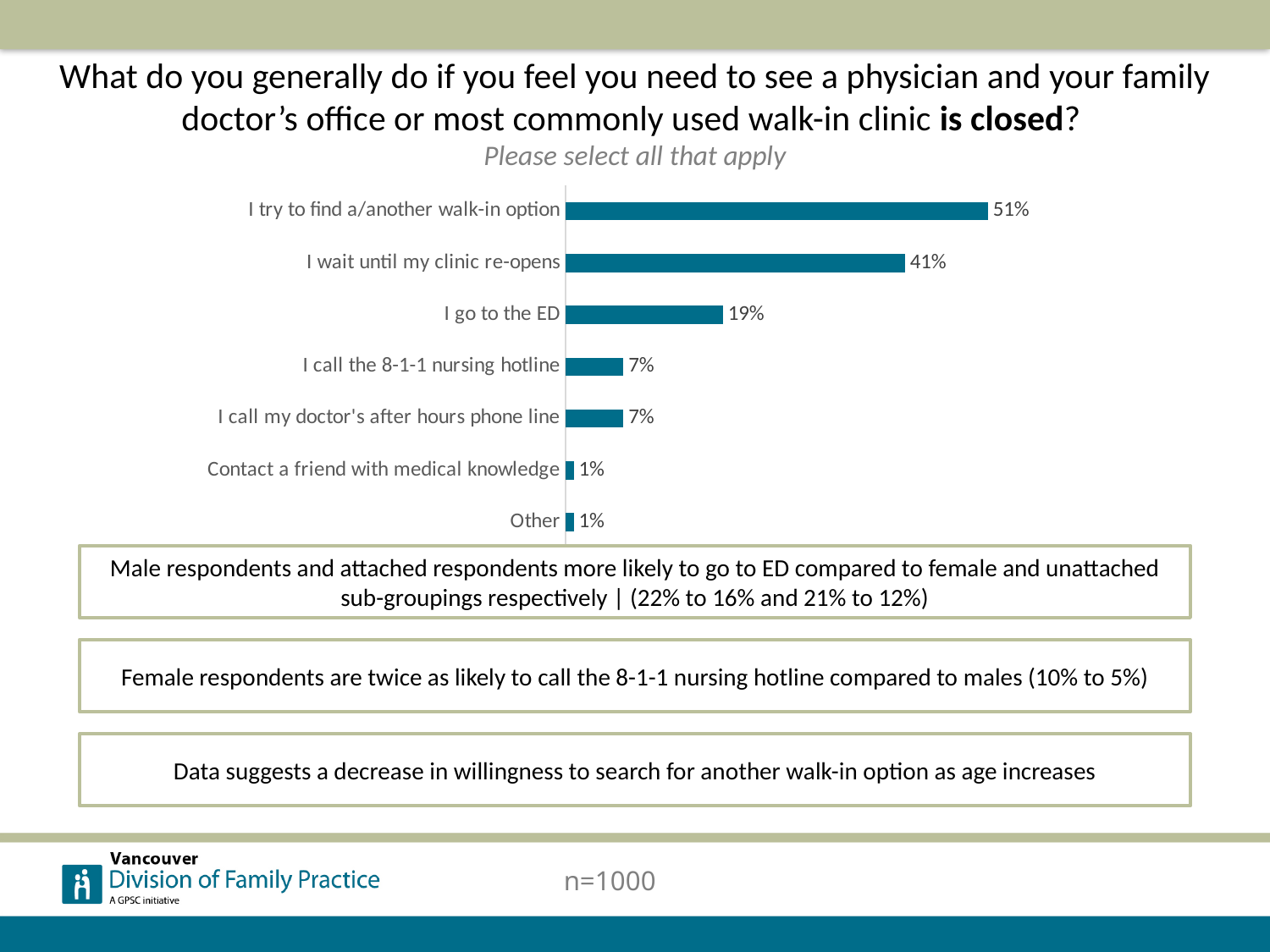
What is the difference in percentage points between 'I wait until my clinic re-opens' and 'I go to the ED'? 22 percentage points What is the difference in percentage points between 'I try to find a/another walk-in option' and 'I wait until my clinic re-opens'? 10 percentage points Which is larger: the percentage for 'I go to the ED' or for 'I call the 8-1-1 nursing hotline'? I go to the ED What is the sample size (n) stated on the slide? n=1000 What percentage of respondents say they try to find a/another walk-in option? 51% What percentage of respondents say they go to the ED? 19% What percentage of respondents say they wait until their clinic re-opens? 41% Which response option has the highest percentage? I try to find a/another walk-in option What type of chart is shown on the slide? Bar chart What percentage of respondents say they call the 8-1-1 nursing hotline? 7% How many response categories are shown in the chart? 7 What percentage of respondents selected 'Other'? 1%